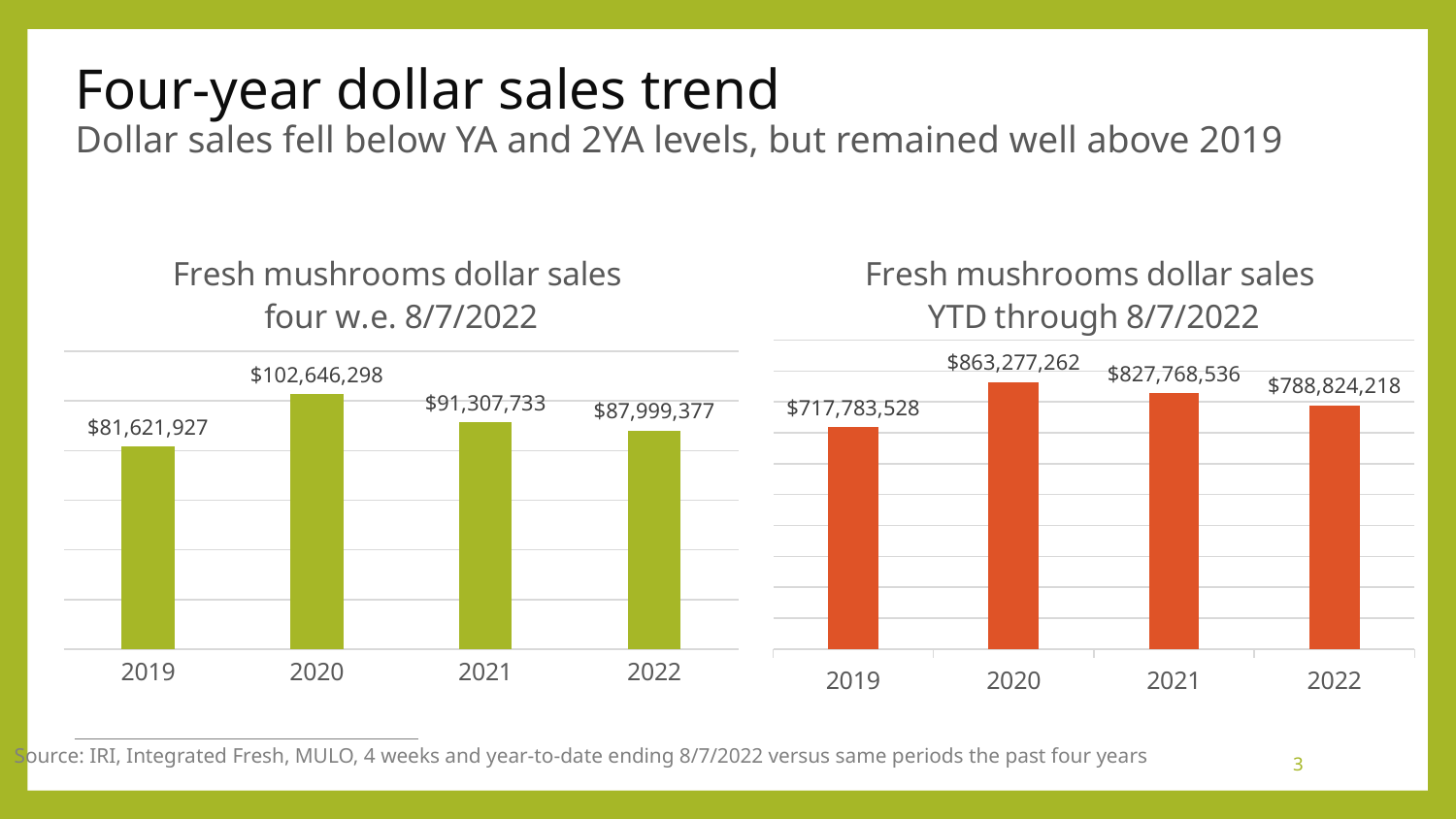
What colour are the bars in the 'Fresh mushrooms dollar sales four w.e. 8/7/2022' chart? Green In the 'Fresh mushrooms dollar sales YTD through 8/7/2022' chart, what is the value for 2022? $788,824,218 In the 'Fresh mushrooms dollar sales YTD through 8/7/2022' chart, do the values rise or fall from 2020 to 2022? Fall How many years are shown in the 'Fresh mushrooms dollar sales four w.e. 8/7/2022' chart? 4 In the 'Fresh mushrooms dollar sales YTD through 8/7/2022' chart, which year has the highest value? 2020 In the 'Fresh mushrooms dollar sales four w.e. 8/7/2022' chart, what is the difference between the 2020 and 2019 values? $21,024,371 In the 'Fresh mushrooms dollar sales four w.e. 8/7/2022' chart, which year has the lowest value? 2019 In the 'Fresh mushrooms dollar sales YTD through 8/7/2022' chart, what is the difference between the 2020 and 2022 values? $74,453,044 In the 'Fresh mushrooms dollar sales four w.e. 8/7/2022' chart, which is larger, the value for 2021 or the value for 2022? 2021 In the 'Fresh mushrooms dollar sales four w.e. 8/7/2022' chart, what is the value for 2020? $102,646,298 In the 'Fresh mushrooms dollar sales YTD through 8/7/2022' chart, which is larger, the value for 2019 or the value for 2021? 2021 What kind of chart is the 'Fresh mushrooms dollar sales YTD through 8/7/2022' chart? Bar chart